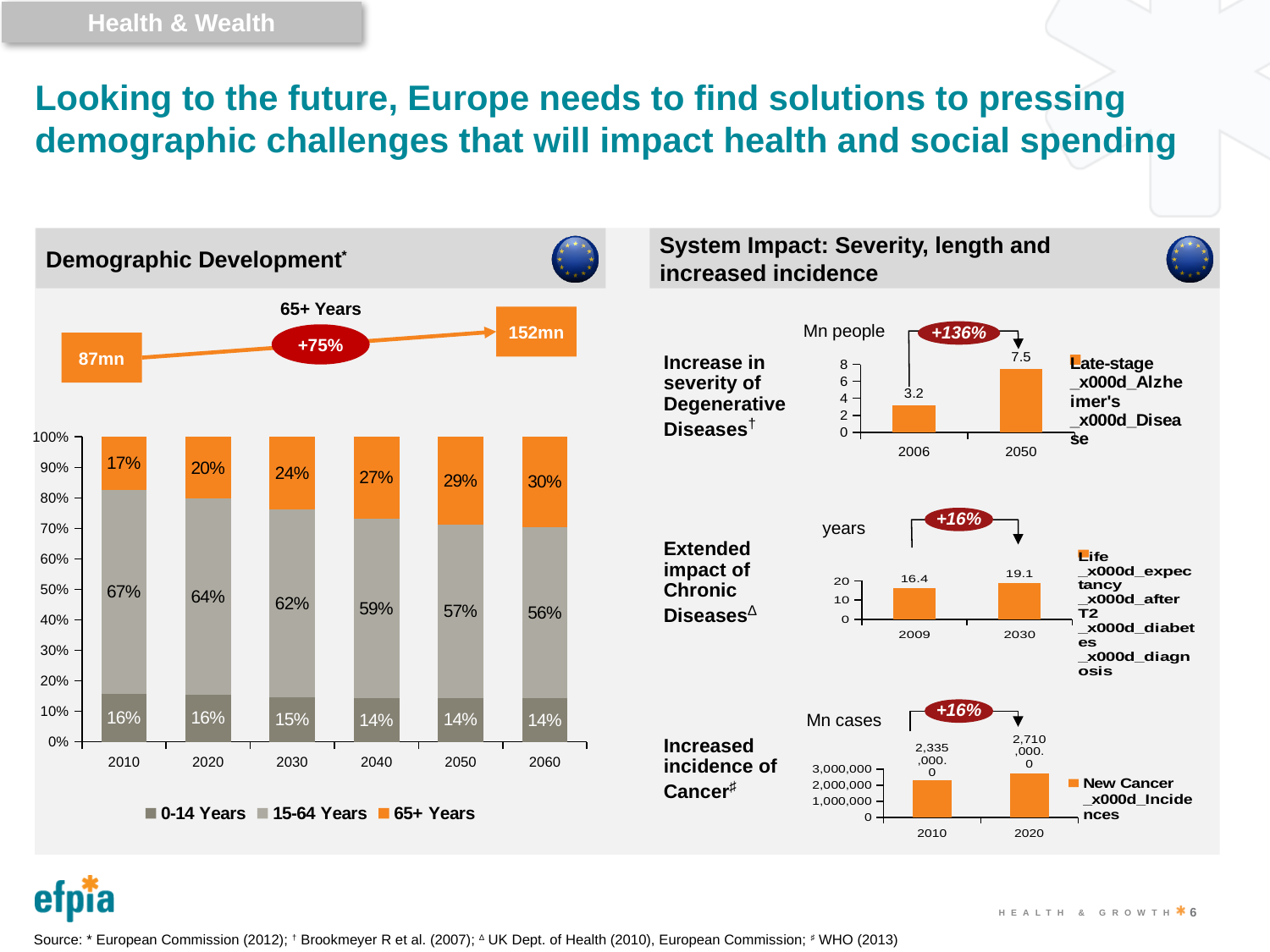
In the Demographic Development chart, how many years are shown on the x axis? 6 In the Late-stage Alzheimer's Disease chart on the right, what is the value for 2050? 7.5 In the New Cancer Incidences chart at the bottom right, which year has the larger value, 2010 or 2020? 2020 In the Late-stage Alzheimer's Disease chart on the right, what is the difference between the 2050 and 2006 values? 4.3 In the Demographic Development chart, what is the value for 15-64 Years in 2010? 67% In the Demographic Development chart, how many series does the legend list? 3 In the Demographic Development chart, what is the value for 65+ Years in 2060? 30% In the Demographic Development chart, what is the difference between the 15-64 Years share in 2010 and in 2060? 11% In the Demographic Development chart, which year has the highest share for 65+ Years? 2060 In the Life expectancy after T2 diabetes diagnosis chart on the right, what is the value for 2009? 16.4 In the Demographic Development chart, what is the value for 0-14 Years in 2030? 15% In the Demographic Development chart, does the 65+ Years share rise or fall from 2010 to 2060? rise